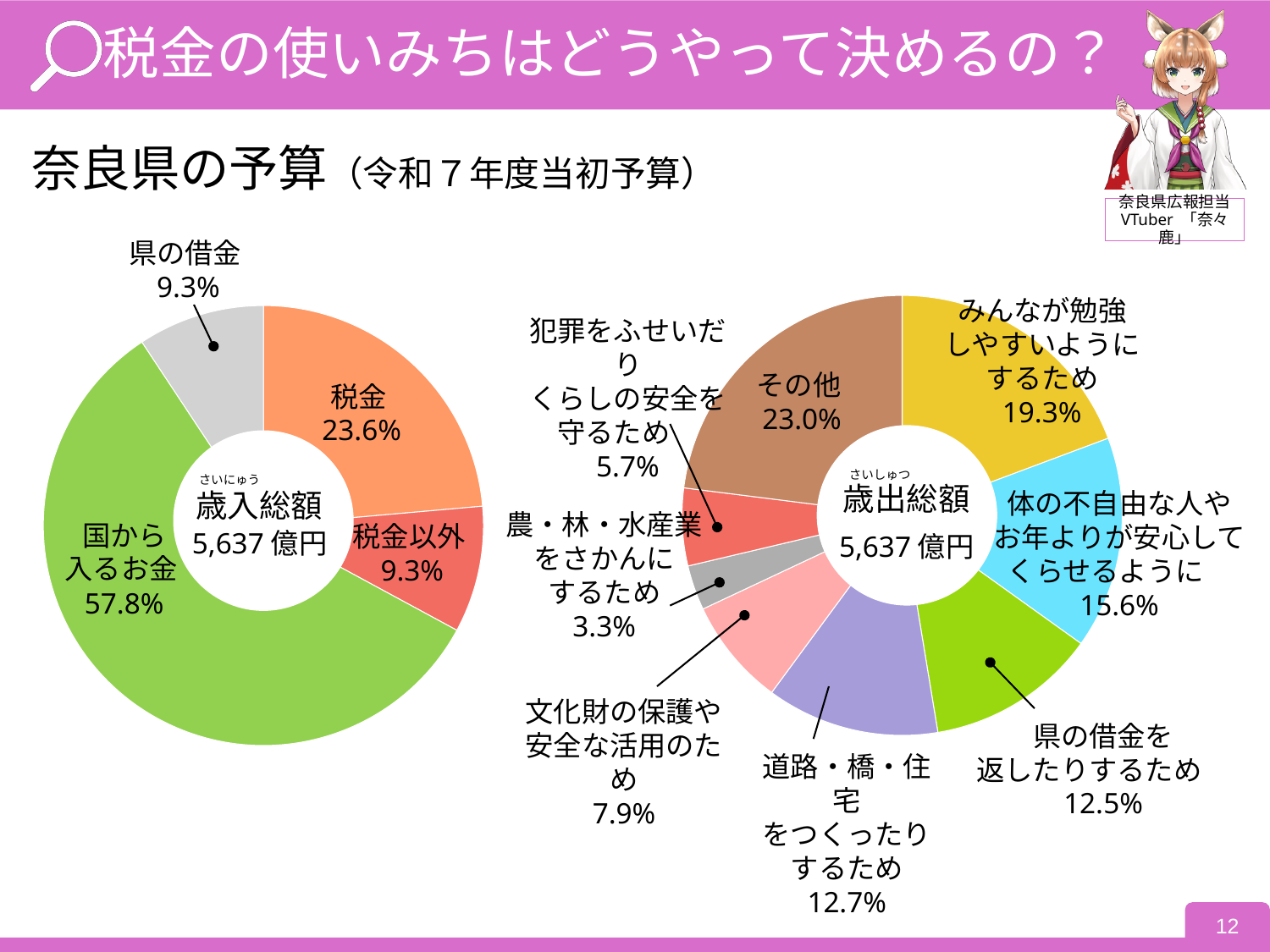
In the left chart (歳入総額), what is the difference between 税金 and 税金以外? 14.3% In the right chart (歳出総額), what share is 道路・橋・住宅をつくったりするため? 12.7% In the right chart (歳出総額), how many categories are shown? 8 In the left chart (歳入総額), which category has the largest share? 国から入るお金 In the left chart (歳入総額), how many categories are shown? 4 In the right chart (歳出総額), which category has the smallest share? 農・林・水産業をさかんにするため In the right chart (歳出総額), which category has the largest share? その他 What total amount is shown in the centre of the left chart (歳入総額)? 5,637 億円 In the left chart (歳入総額), what share is 国から入るお金? 57.8% In the right chart (歳出総額), what share is 農・林・水産業をさかんにするため? 3.3% In the left chart (歳入総額), what share is 税金? 23.6% What kind of chart is used on this slide? Pie (donut) chart